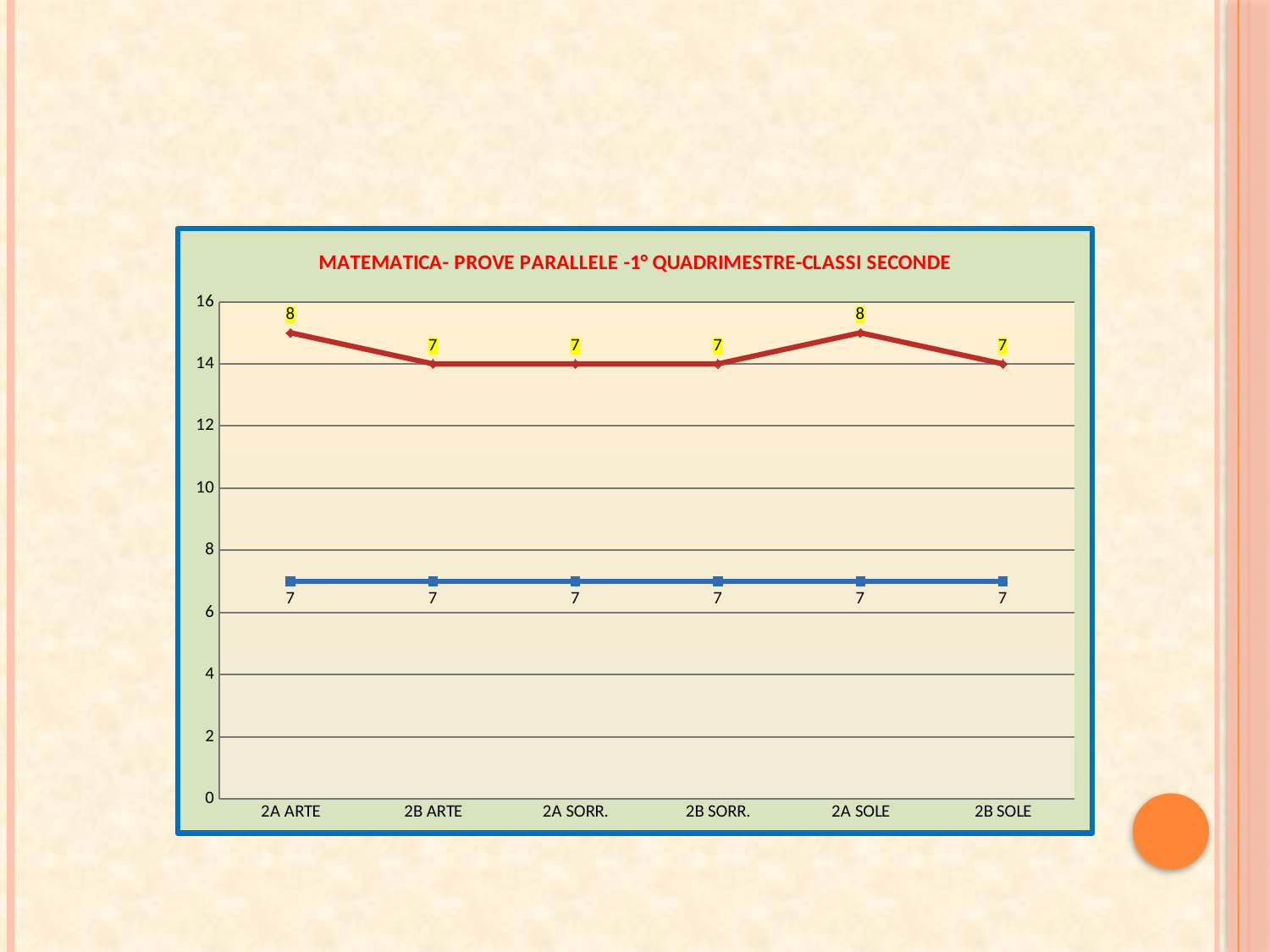
What is the data label on the red line for 2A ARTE? 8 What is the title of the chart? MATEMATICA- PROVE PARALLELE -1° QUADRIMESTRE-CLASSI SECONDE On the red line, which has the larger data label: 2A ARTE or 2B ARTE? 2A ARTE How many lines are plotted on the chart? 2 Is the value of the blue line for 2B SORR. greater or less than 8? less What is the data label on the blue line for 2A SOLE? 7 What is the difference between the red line's data labels for 2A SOLE and 2B SOLE? 1 How many categories are shown on the x axis of the chart? 6 Which categories have the highest data label on the red line? 2A ARTE and 2A SOLE What is the data label on the red line for 2B ARTE? 7 Does the blue line rise, fall, or stay flat across the categories? stays flat What kind of chart is shown on the slide? line chart